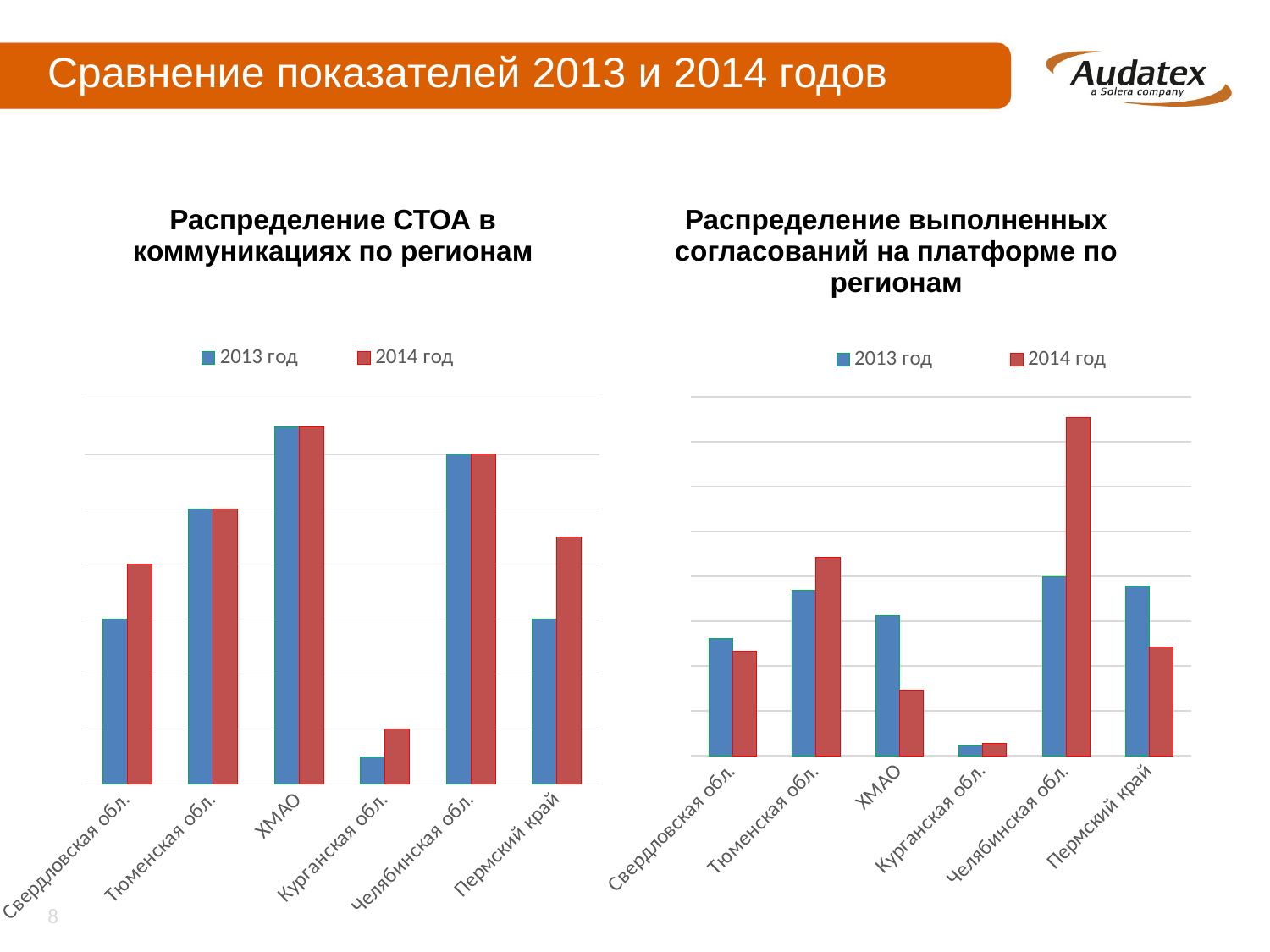
In the left chart, 'Распределение СТОА в коммуникациях по регионам', which region has the lowest value for 2013 год? Курганская обл. What are the two legend entries of the left chart, 'Распределение СТОА в коммуникациях по регионам'? 2013 год, 2014 год In the right chart, 'Распределение выполненных согласований на платформе по регионам', which region has the highest value for 2014 год? Челябинская обл. How many series does the legend of the right chart, 'Распределение выполненных согласований на платформе по регионам', list? 2 In the right chart, 'Распределение выполненных согласований на платформе по регионам', which is larger for Тюменская обл.: 2013 год or 2014 год? 2014 год What kind of chart is the left chart, 'Распределение СТОА в коммуникациях по регионам'? bar chart What is the title of the right chart on the slide? Распределение выполненных согласований на платформе по регионам In the right chart, 'Распределение выполненных согласований на платформе по регионам', which region has the lowest value for 2014 год? Курганская обл. In the left chart, 'Распределение СТОА в коммуникациях по регионам', which is larger for Пермский край: 2013 год or 2014 год? 2014 год In the right chart, 'Распределение выполненных согласований на платформе по регионам', which is larger for ХМАО: 2013 год or 2014 год? 2013 год In the left chart, 'Распределение СТОА в коммуникациях по регионам', which region has the highest value for 2014 год? ХМАО How many regions are shown on the x axis of the left chart, 'Распределение СТОА в коммуникациях по регионам'? 6